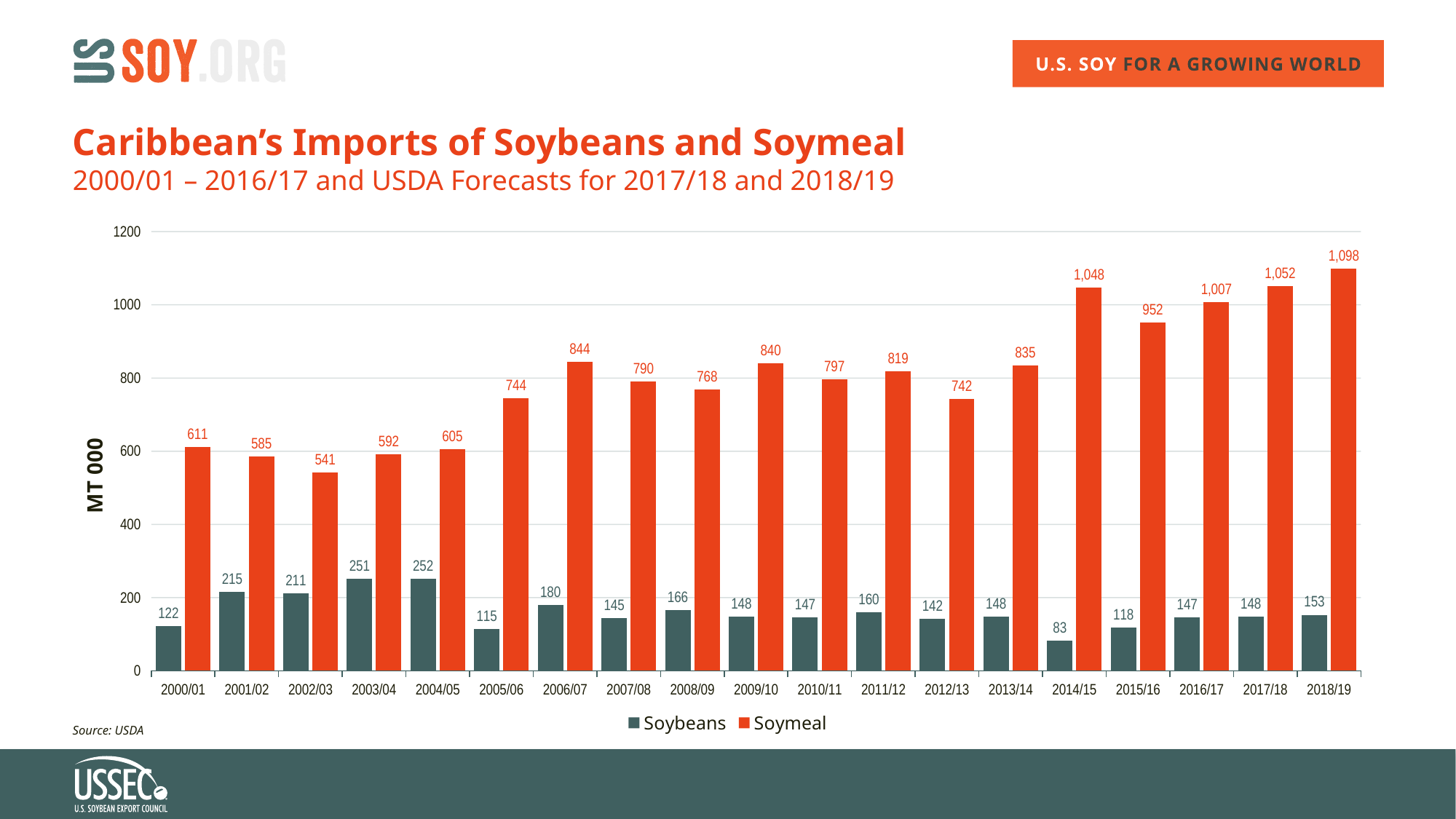
Which year has the highest Soymeal value? 2018/19 What is the Soybeans import value for 2014/15? 83 How many series does the legend list? 2 Which year has the lowest Soybeans value? 2014/15 How many years are shown on the x axis? 19 Which is larger, the Soybeans value for 2003/04 or for 2005/06? 2003/04 What kind of chart is shown on the slide? Bar chart Is the Soymeal value for 2015/16 greater or less than 1000? less What is the label on the vertical axis? MT 000 What is the difference between the Soymeal values for 2018/19 and 2000/01? 487 What is the Soymeal import value for 2018/19? 1,098 Do the Soymeal values generally rise or fall from 2000/01 to 2018/19? Rise